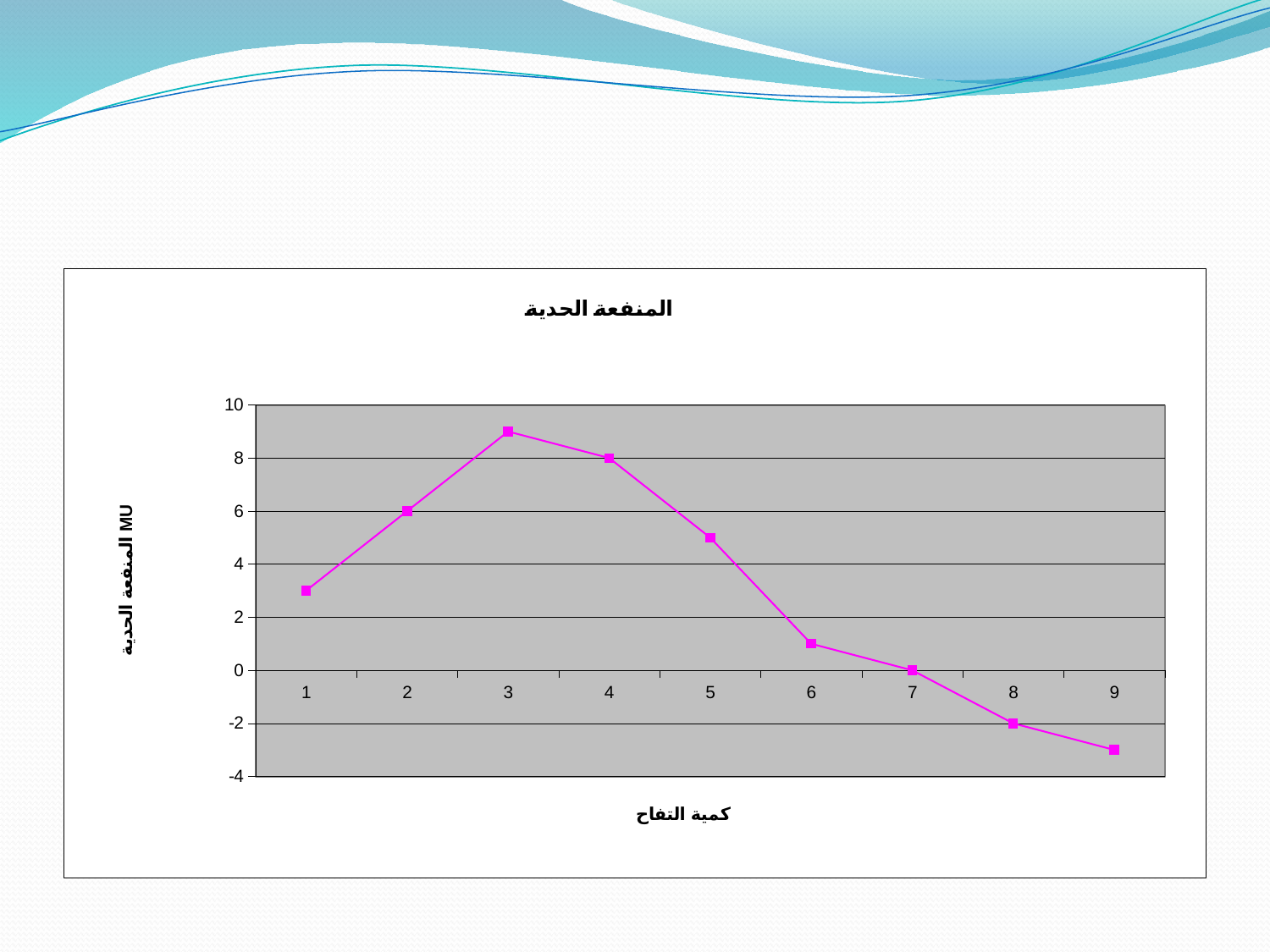
What is the marginal utility value at quantity 7? 0 At which quantity is the marginal utility highest? 3 What is the marginal utility value at quantity 2? 6 How many data points are plotted on the line? 9 What is the label of the x axis? كمية التفاح What is the marginal utility value at quantity 4? 8 What type of chart is shown on the slide? line chart Is the value at quantity 3 greater or less than 8? greater What is the title of the chart? المنفعة الحدية What is the difference between the values at quantity 4 and quantity 2? 2 What is the marginal utility value at quantity 8? -2 At which quantity is the marginal utility lowest? 9